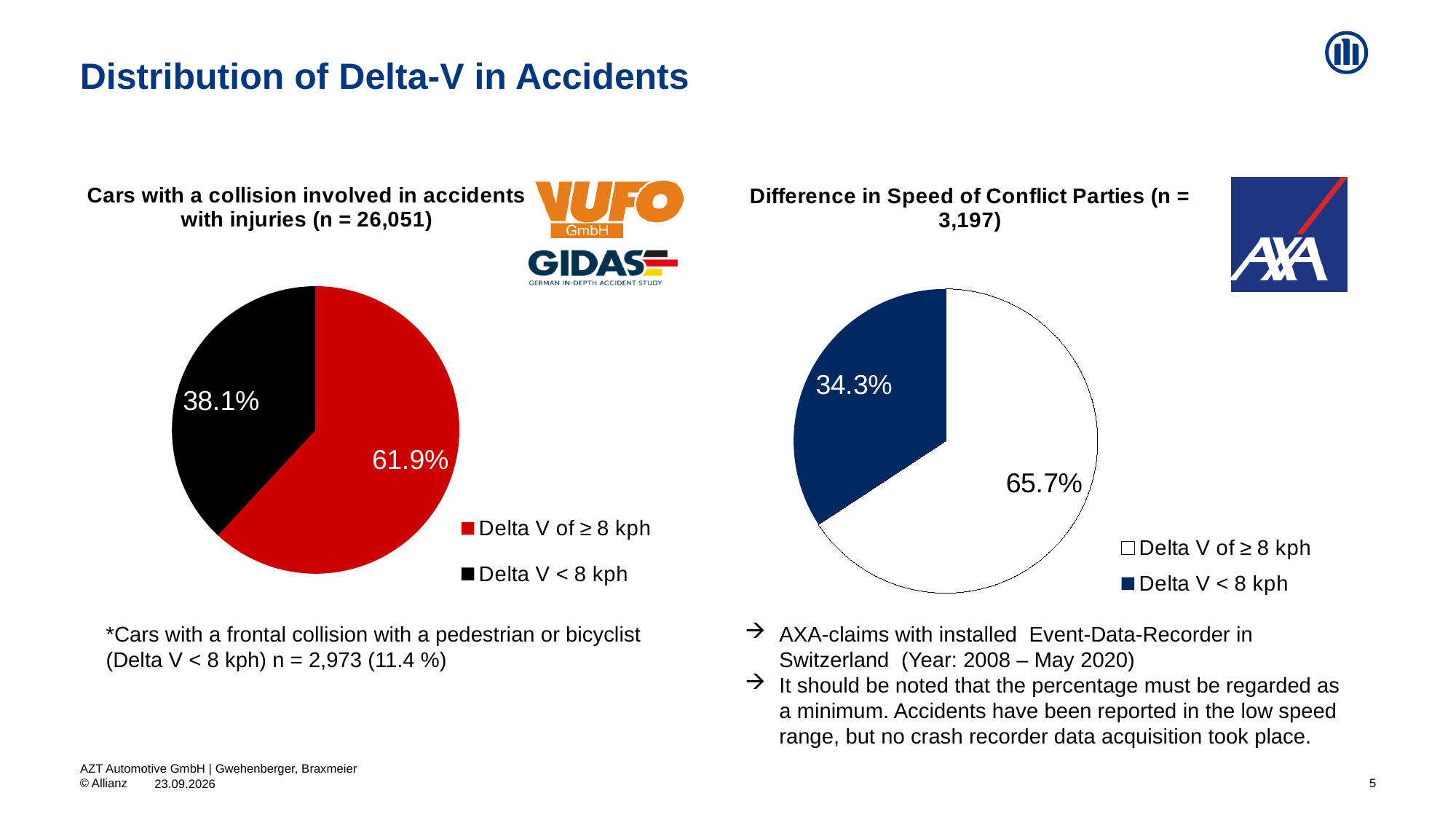
In the left chart (Cars with a collision involved in accidents with injuries), which category has the largest slice? Delta V of ≥ 8 kph In the left chart (Cars with a collision involved in accidents with injuries), what is the difference in percentage points between the Delta V of ≥ 8 kph slice and the Delta V < 8 kph slice? 23.8 percentage points In the right chart (Difference in Speed of Conflict Parties), what share is labelled for Delta V of ≥ 8 kph? 65.7% In the right chart (Difference in Speed of Conflict Parties), which category has the smallest slice? Delta V < 8 kph How many slices does the right chart (Difference in Speed of Conflict Parties) have? 2 What type of chart is used on the left of the slide (Cars with a collision involved in accidents with injuries)? Pie chart In the left chart (Cars with a collision involved in accidents with injuries), what share is labelled for Delta V of ≥ 8 kph? 61.9% In the right chart (Difference in Speed of Conflict Parties), what share is labelled for Delta V < 8 kph? 34.3% In the left chart (Cars with a collision involved in accidents with injuries), what share is labelled for Delta V < 8 kph? 38.1% How many entries does the legend of the left chart (Cars with a collision involved in accidents with injuries) list? 2 In the right chart (Difference in Speed of Conflict Parties), what colour is the Delta V < 8 kph slice? Dark blue Which is larger: the Delta V < 8 kph share in the left chart or the Delta V < 8 kph share in the right chart? The left chart (38.1%)